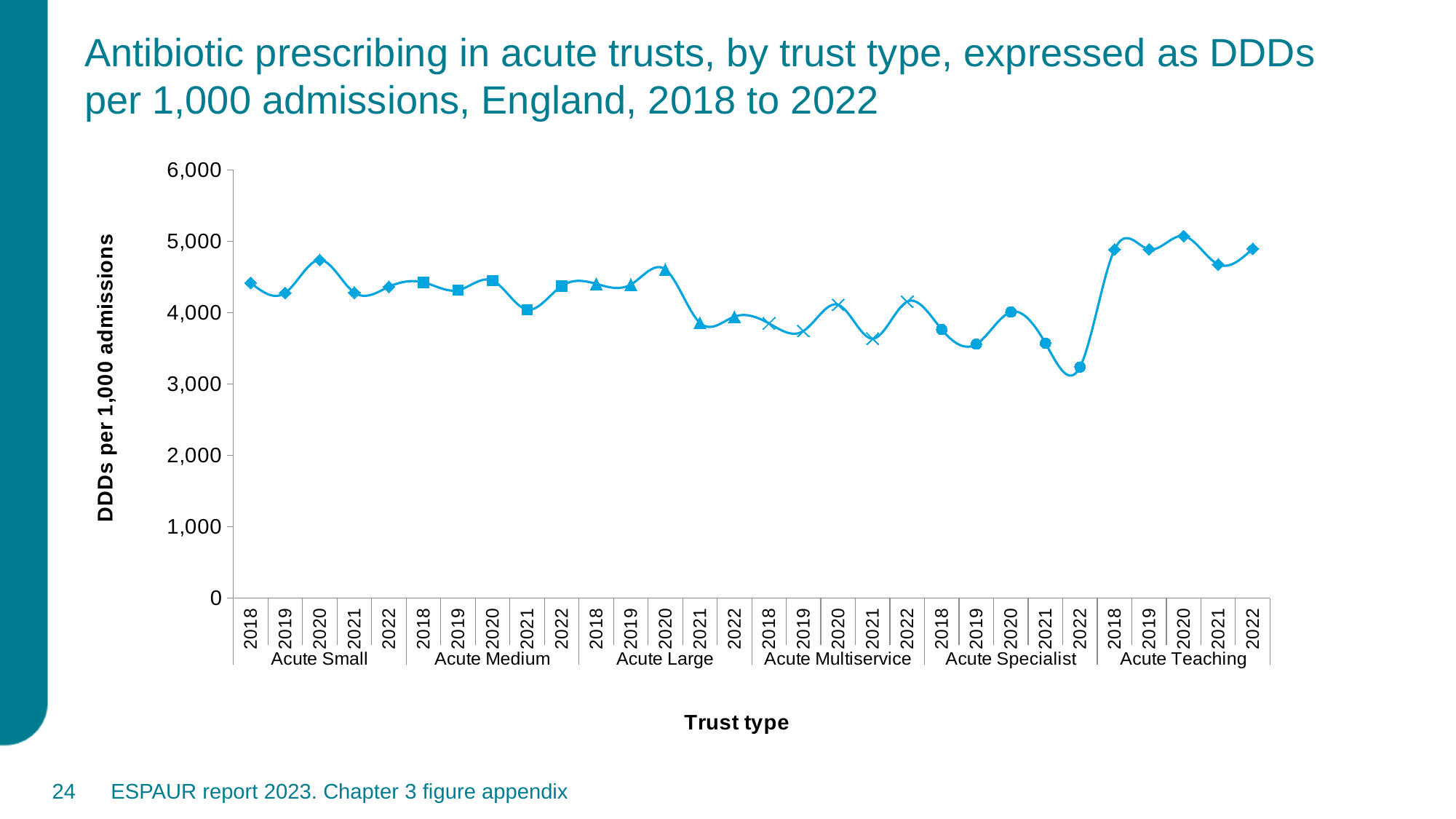
Is the value for Acute Teaching in 2020 greater or less than 5,000? greater Which trust type and year has the highest DDDs per 1,000 admissions? Acute Teaching, 2020 Do the values for Acute Specialist rise or fall from 2020 to 2022? fall What is the title of the x axis? Trust type What kind of chart is shown on the slide? line chart Which is larger: the value for Acute Teaching in 2018 or the value for Acute Specialist in 2018? Acute Teaching in 2018 What is the title of the y axis? DDDs per 1,000 admissions Is the value for Acute Small in 2020 greater or less than 4,000? greater How many trust types are shown along the x axis? 6 Which trust type and year has the lowest DDDs per 1,000 admissions? Acute Specialist, 2022 Is the value for Acute Multiservice in 2021 greater or less than 4,000? less How many data points are plotted in total on the chart? 30